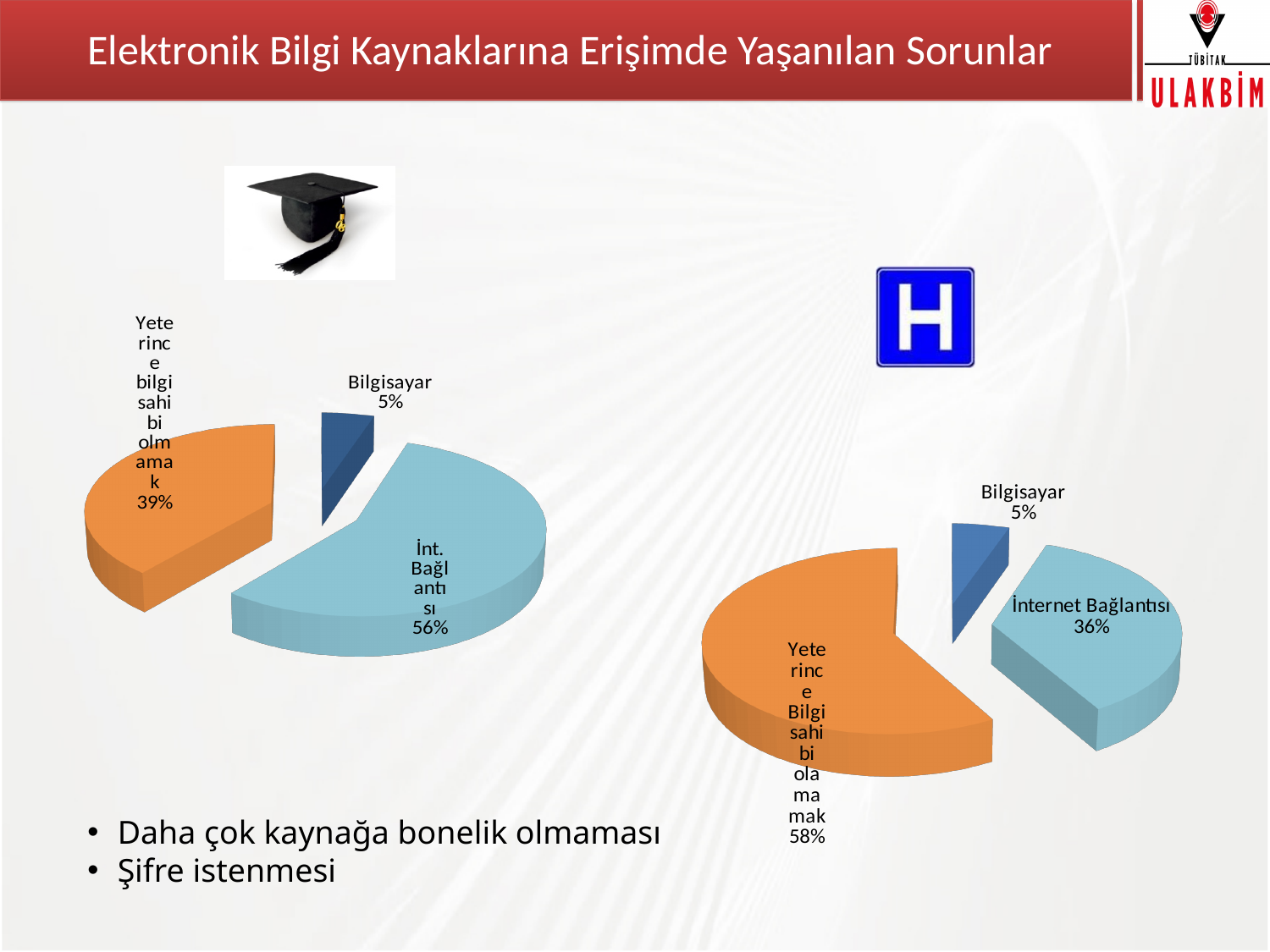
In the right pie chart, what is the difference in percentage points between Yeterince Bilgi sahibi olamamak and İnternet Bağlantısı? 22 Which is larger: the İnt. Bağlantısı share in the left pie chart or the İnternet Bağlantısı share in the right pie chart? the left pie chart (56%) In the left pie chart, what share is labelled for Yeterince bilgi sahibi olmamak? 39% In the right pie chart, what share is labelled for İnternet Bağlantısı? 36% In the left pie chart, what share is labelled for Bilgisayar? 5% In the left pie chart, which category has the smallest share? Bilgisayar In the left pie chart, which category has the largest share? İnt. Bağlantısı What kind of chart is the chart on the left of the slide? pie chart In the right pie chart, which category has the largest share? Yeterince Bilgi sahibi olamamak In the left pie chart, what share is labelled for İnt. Bağlantısı? 56% In the right pie chart, what share is labelled for Yeterince Bilgi sahibi olamamak? 58% How many slices does the left pie chart have? 3